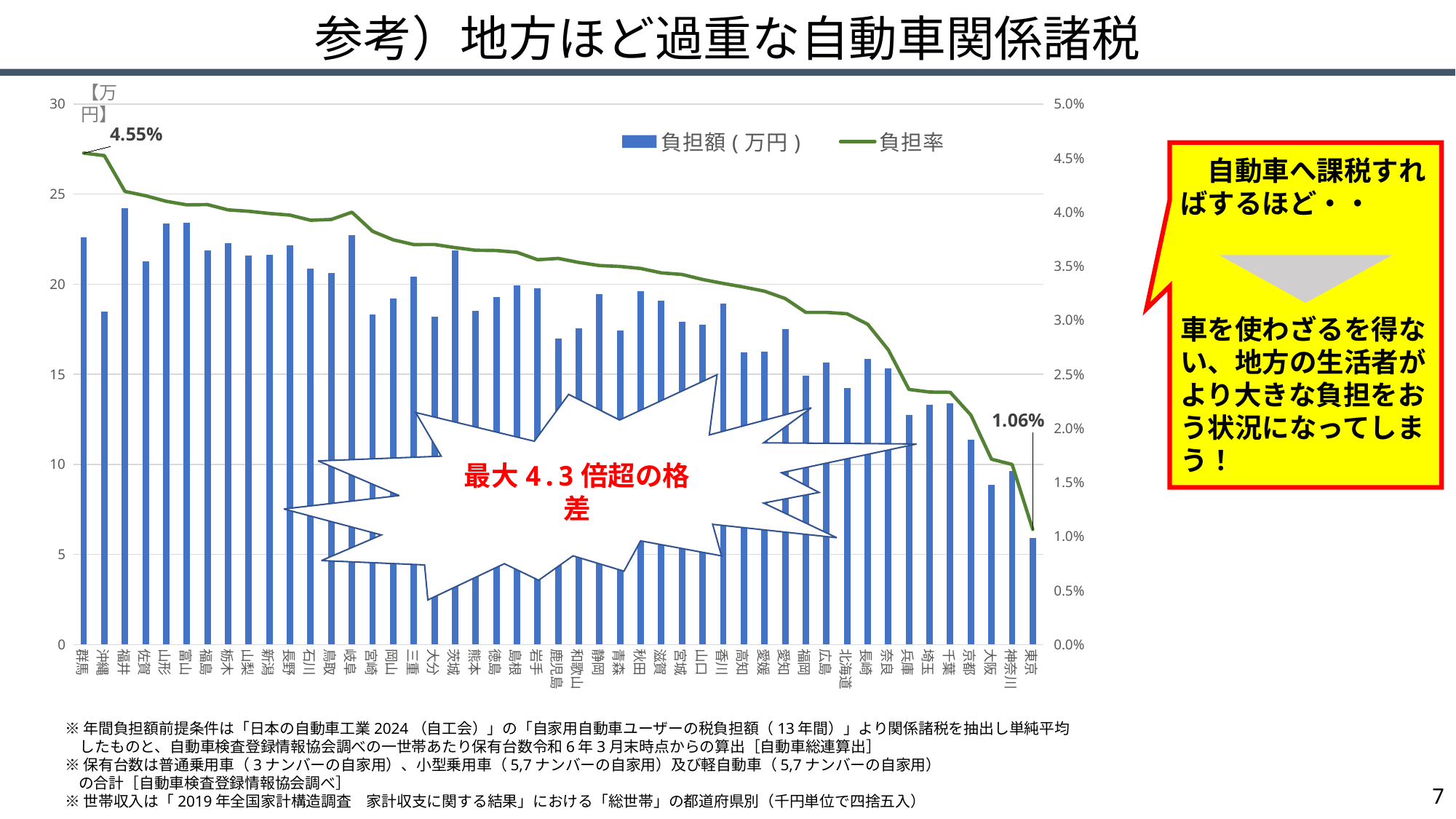
What is the 負担率 value shown for 東京? 1.06% What kind of chart is shown on the slide? Combined bar and line chart Which prefecture has the lowest 負担額 (万円) bar? 東京 How many prefectures are plotted along the x axis? 47 Which prefecture has the highest 負担率? 群馬 Is the 負担額 (万円) value for 東京 greater or less than 10? less Does the 負担率 line rise or fall from left to right along the x axis? fall What is the 負担率 value shown for 群馬? 4.55% What is the difference between the 負担率 of 群馬 and that of 東京? 3.49% Which has the larger 負担率, 群馬 or 東京? 群馬 How many series does the legend list? 2 Is the 負担額 (万円) value for 福井 greater or less than 20? greater